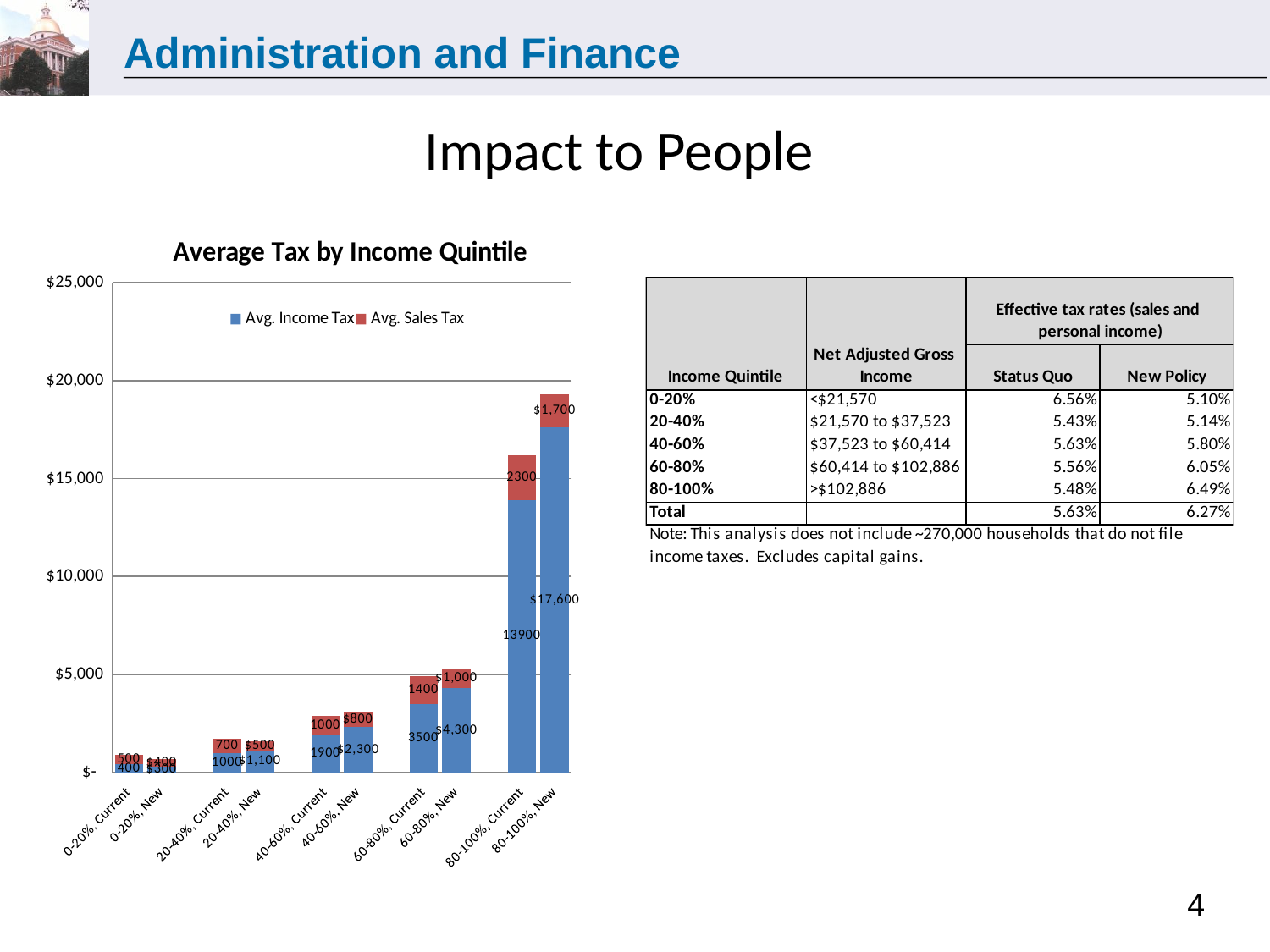
Which bar has the highest total in the "Average Tax by Income Quintile" chart? 80-100%, New Which is larger, the Avg. Sales Tax for "60-80%, Current" or for "60-80%, New"? 60-80%, Current What is the Avg. Income Tax value for "60-80%, New"? $4,300 What is the total of the stacked bar for "80-100%, Current"? $16,200 What is the Avg. Income Tax value for "80-100%, New"? $17,600 How many series does the legend of the "Average Tax by Income Quintile" chart list? 2 What is the Avg. Sales Tax value for "80-100%, Current"? 2300 How many bars are plotted in the "Average Tax by Income Quintile" chart? 10 What kind of chart is "Average Tax by Income Quintile"? Stacked bar chart How much higher is the Avg. Income Tax for "80-100%, New" than for "80-100%, Current"? $3,700 What is the total of the stacked bar for "80-100%, New"? $19,300 Is the total of the "80-100%, Current" bar greater or less than $15,000? greater